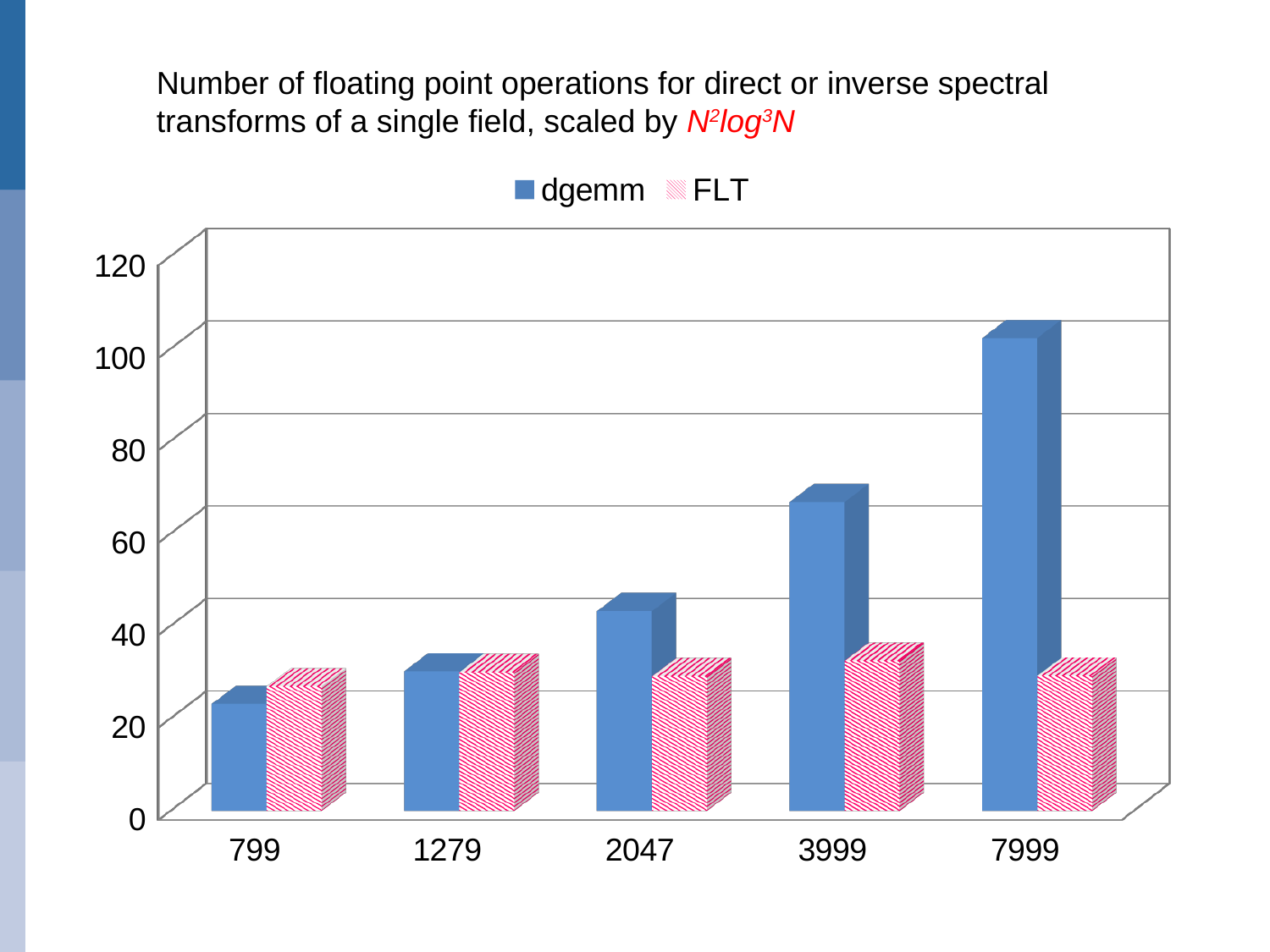
Is the dgemm value for 7999 greater or less than 80? greater What kind of chart is shown on the slide? bar chart For which category is the dgemm value highest? 7999 Is the dgemm value for 2047 greater or less than 60? less What are the two series named in the legend? dgemm and FLT Do the dgemm values rise or fall as you move from 799 to 7999 along the x axis? rise How many categories are shown on the x axis? 5 For which category is the dgemm value lowest? 799 Is the dgemm value for 799 greater or less than 40? less For category 7999, which series has the larger value, dgemm or FLT? dgemm How many series does the legend list? 2